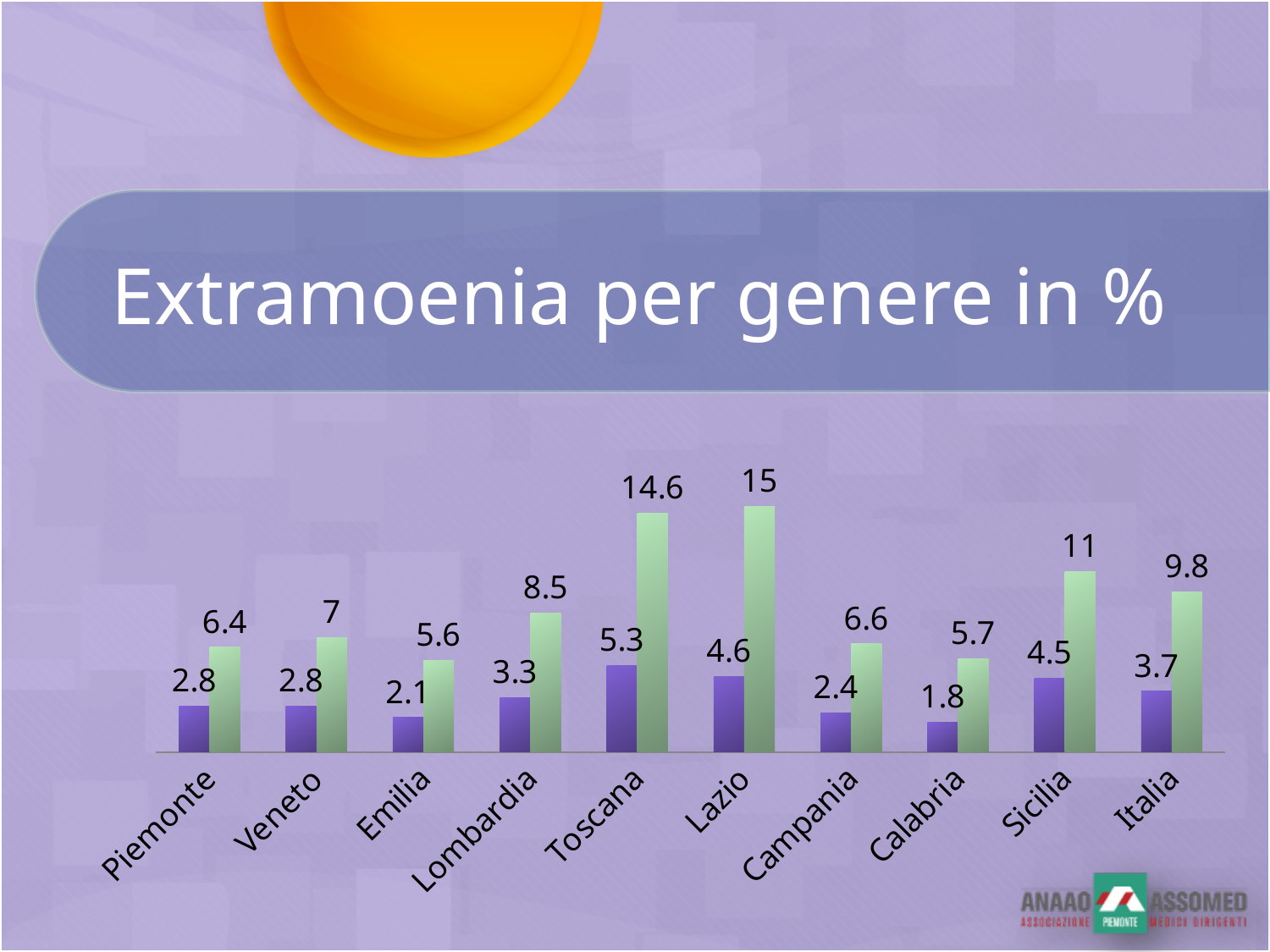
Which region has the highest purple bar? Toscana What is the value of the green bar for Italia? 9.8 How many regions are shown on the x axis? 10 What is the value of the purple bar for Lombardia? 3.3 What type of chart is shown on the slide? Bar chart What is the value of the purple bar for Calabria? 1.8 Which region has the lowest purple bar? Calabria What is the difference between the green bars for Sicilia and Campania? 4.4 What is the value of the green bar for Toscana? 14.6 What is the difference between the green and purple bars for Lazio? 10.4 Which is larger, the green bar for Veneto or the green bar for Emilia? Veneto Which region has the highest green bar? Lazio